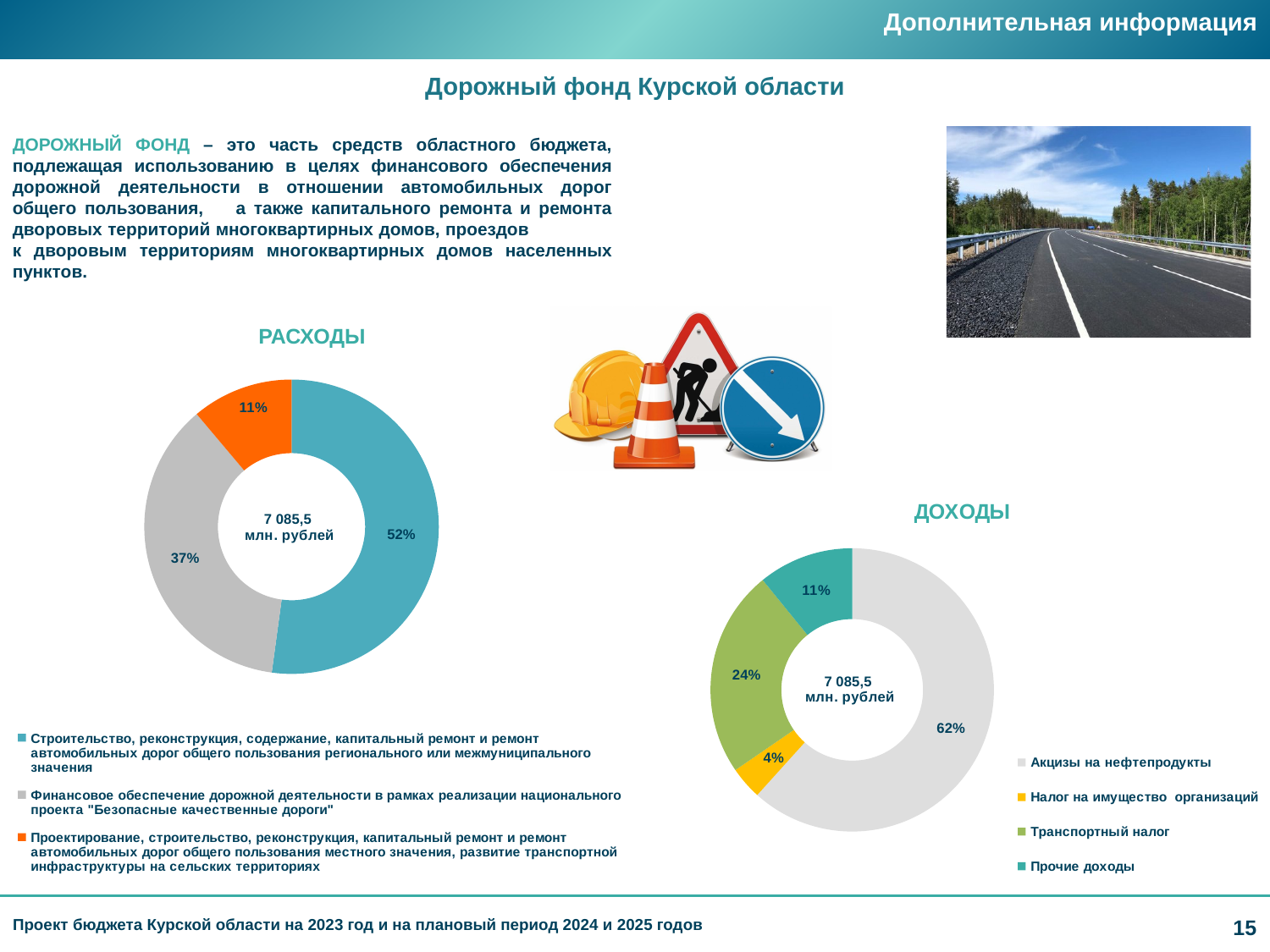
In the ДОХОДЫ chart, what share is shown for Транспортный налог? 24% In the ДОХОДЫ chart, what share is shown for Акцизы на нефтепродукты? 62% In the РАСХОДЫ chart, what share is shown for the orange slice (Проектирование, строительство, реконструкция, капитальный ремонт и ремонт автомобильных дорог общего пользования местного значения)? 11% How many slices does the ДОХОДЫ chart have? 4 In the РАСХОДЫ chart, what share is shown for the largest slice (Строительство, реконструкция, содержание, капитальный ремонт и ремонт автомобильных дорог общего пользования регионального или межмуниципального значения)? 52% In the РАСХОДЫ chart, what share is shown for Финансовое обеспечение дорожной деятельности в рамках реализации национального проекта "Безопасные качественные дороги"? 37% What type of chart is used for РАСХОДЫ? Donut (pie) chart In the ДОХОДЫ chart, what share is shown for Налог на имущество организаций? 4% In the ДОХОДЫ chart, which category has the smallest share? Налог на имущество организаций In the РАСХОДЫ chart, what total value is printed in the centre of the donut? 7 085,5 млн. рублей In the ДОХОДЫ chart, which category has the largest share? Акцизы на нефтепродукты In the ДОХОДЫ chart, what is the difference in percentage points between Акцизы на нефтепродукты and Транспортный налог? 38